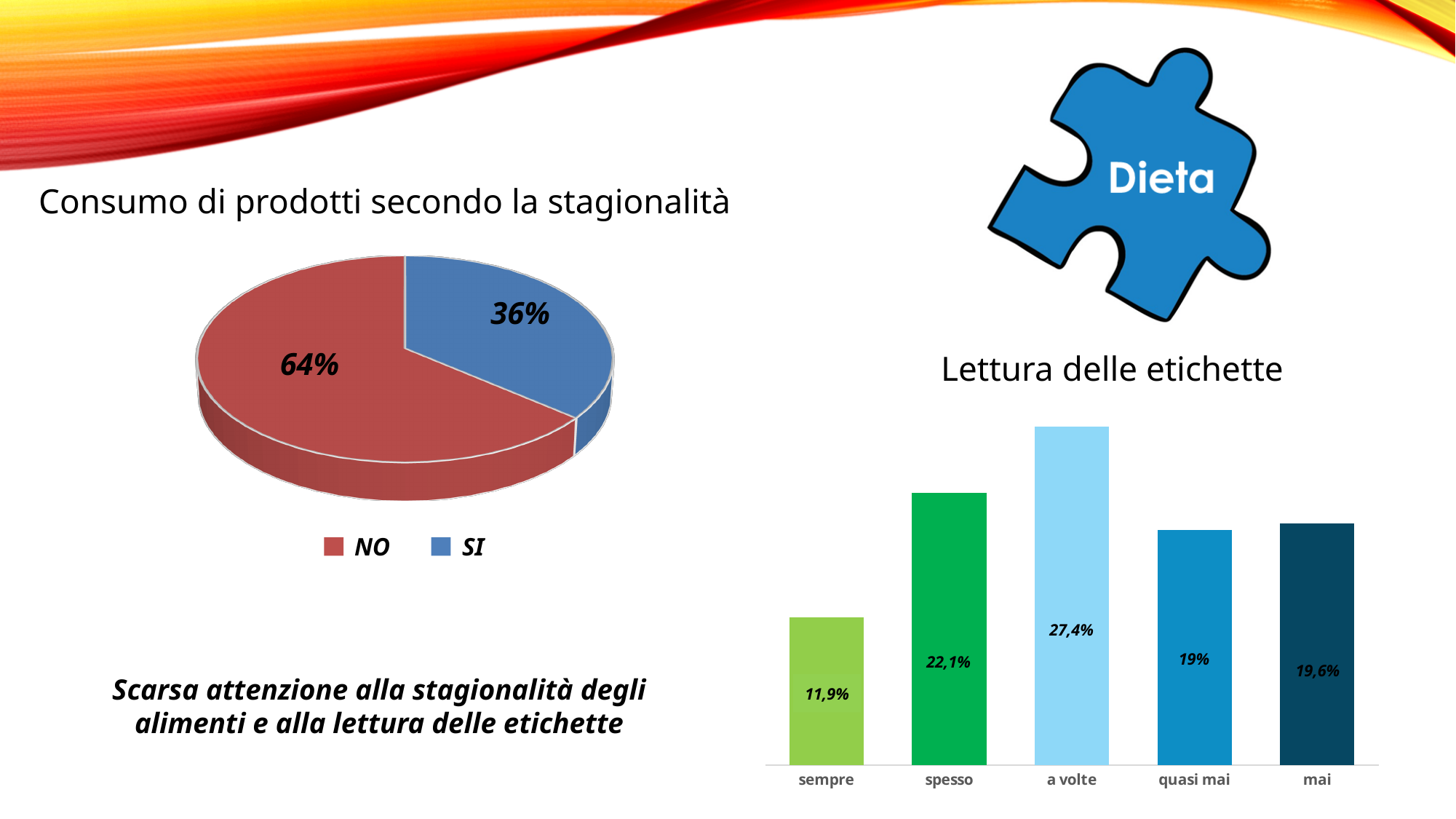
In the 'Lettura delle etichette' chart, which category has the highest value? a volte In the 'Lettura delle etichette' chart, what is the value for 'sempre'? 11,9% In the 'Lettura delle etichette' chart, what is the difference between 'spesso' and 'quasi mai'? 3,1% In the 'Consumo di prodotti secondo la stagionalità' chart, what share is labelled for SI? 36% What kind of chart is 'Lettura delle etichette'? Bar chart In the 'Lettura delle etichette' chart, which category has the lowest value? sempre How many entries does the legend of the 'Consumo di prodotti secondo la stagionalità' chart list? 2 What kind of chart is 'Consumo di prodotti secondo la stagionalità'? Pie chart How many categories are shown in the 'Lettura delle etichette' chart? 5 In the 'Consumo di prodotti secondo la stagionalità' chart, which slice is larger, NO or SI? NO In the 'Lettura delle etichette' chart, what is the value for 'a volte'? 27,4% In the 'Consumo di prodotti secondo la stagionalità' chart, what share is labelled for NO? 64%